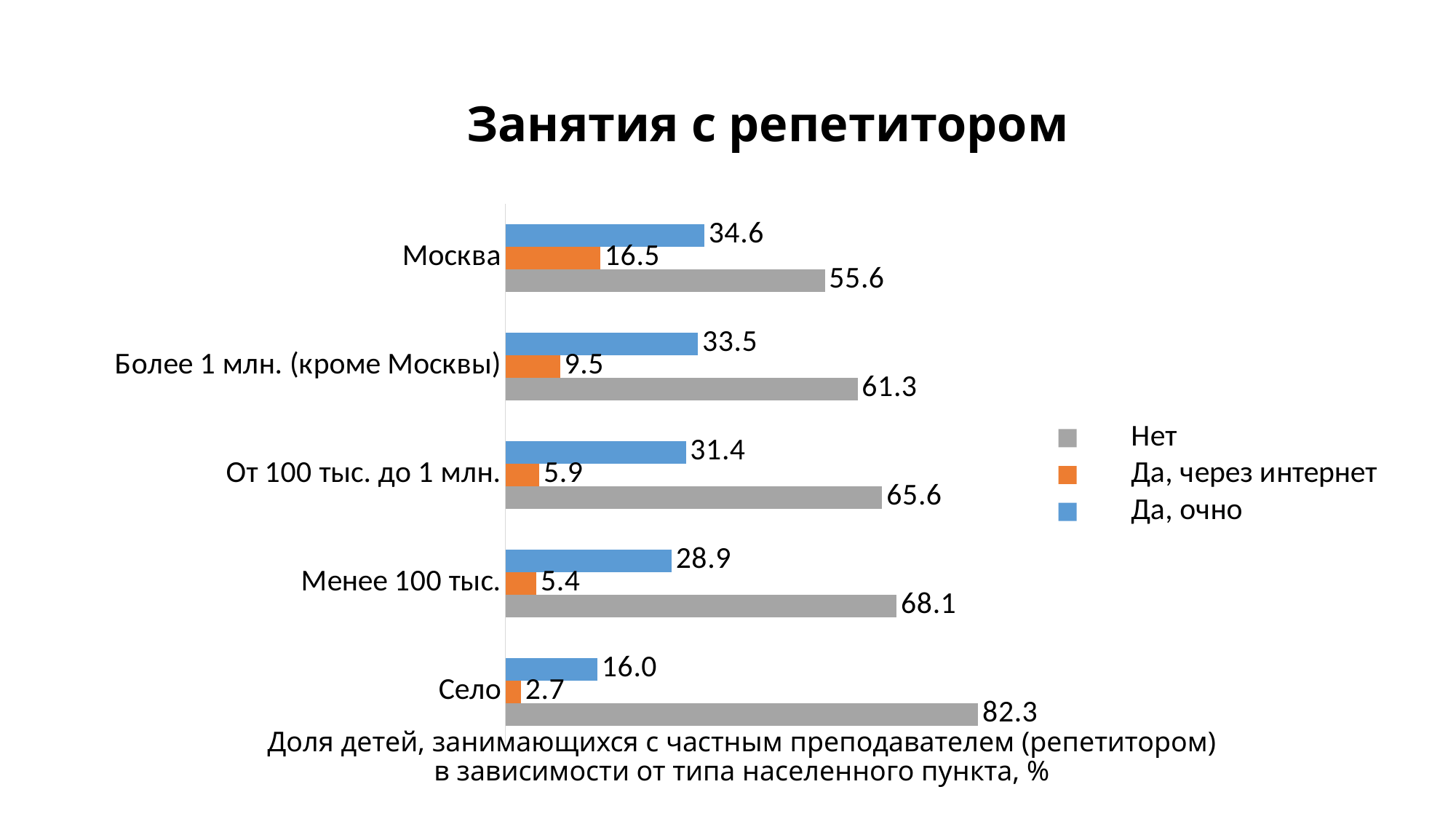
What is the title of the chart? Занятия с репетитором How many series does the legend list? 3 Which colour represents the "Да, через интернет" series? Orange Which category has the highest value for "Нет"? Село What is the difference between the "Нет" values for Село and Москва? 26.7 What is the value for "Да, очно" in Москва? 34.6 What is the value for "Да, через интернет" in "От 100 тыс. до 1 млн."? 5.9 Which is larger: "Да, очно" for Москва or for "Более 1 млн. (кроме Москвы)"? Москва Which category has the lowest value for "Да, через интернет"? Село How many categories are shown on the chart? 5 What is the value for "Нет" in Село? 82.3 What kind of chart is shown on the slide? Bar chart